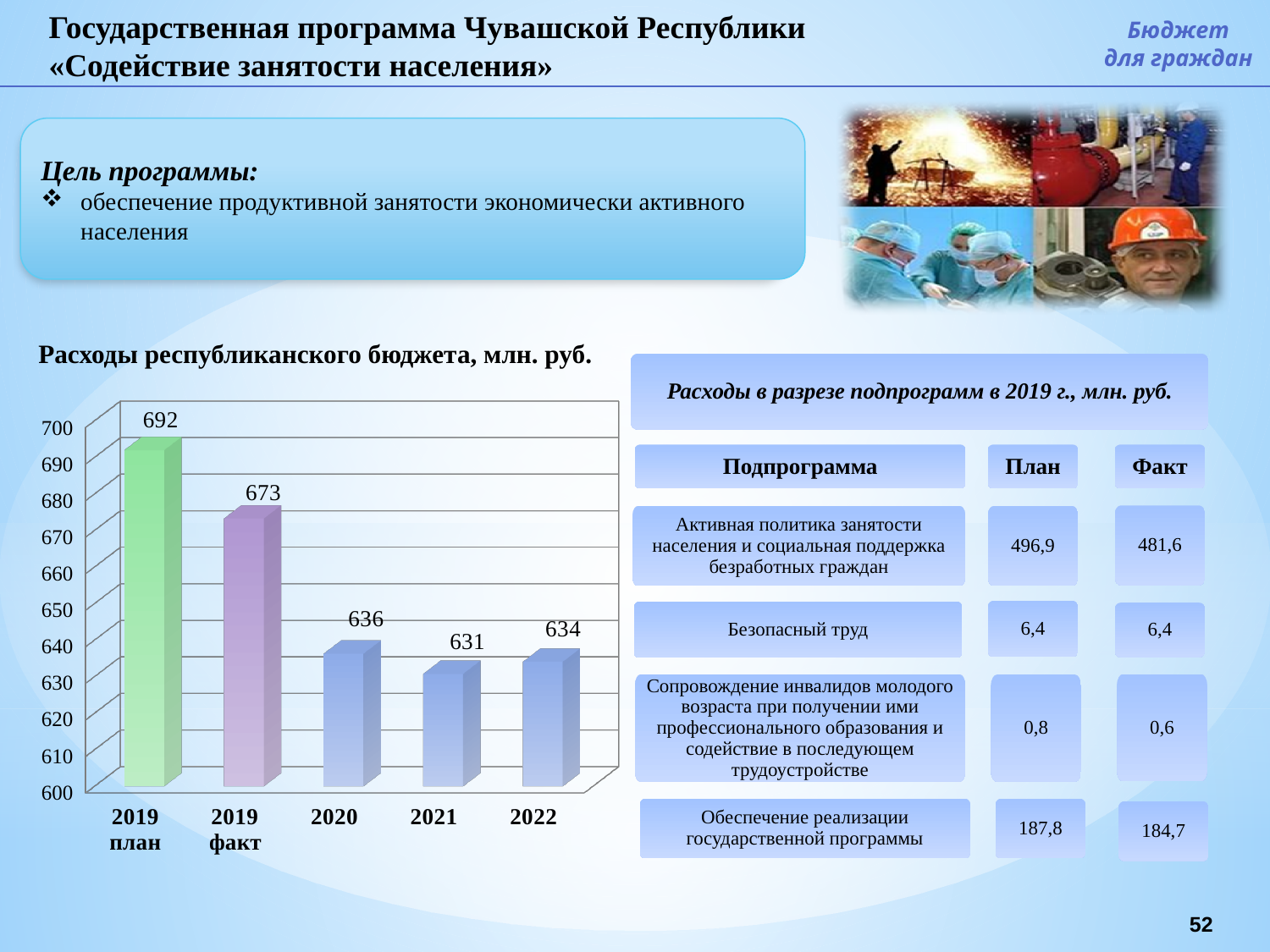
Which is larger, the value for 2020 or the value for 2021? 2020 What kind of chart is shown on the slide? bar chart What is the difference between the values for 2020 and 2022? 2 What is the value for 2019 факт in the chart? 673 What is the value for 2022 in the chart? 634 What is the title of the chart on the slide? Расходы республиканского бюджета, млн. руб. What is the value for 2019 план in the chart 'Расходы республиканского бюджета, млн. руб.'? 692 Which category has the lowest value in the chart? 2021 What is the value for 2021 in the chart? 631 Which category has the highest value in the chart? 2019 план What is the difference between the values for 2019 план and 2019 факт? 19 How many bars are shown in the chart? 5